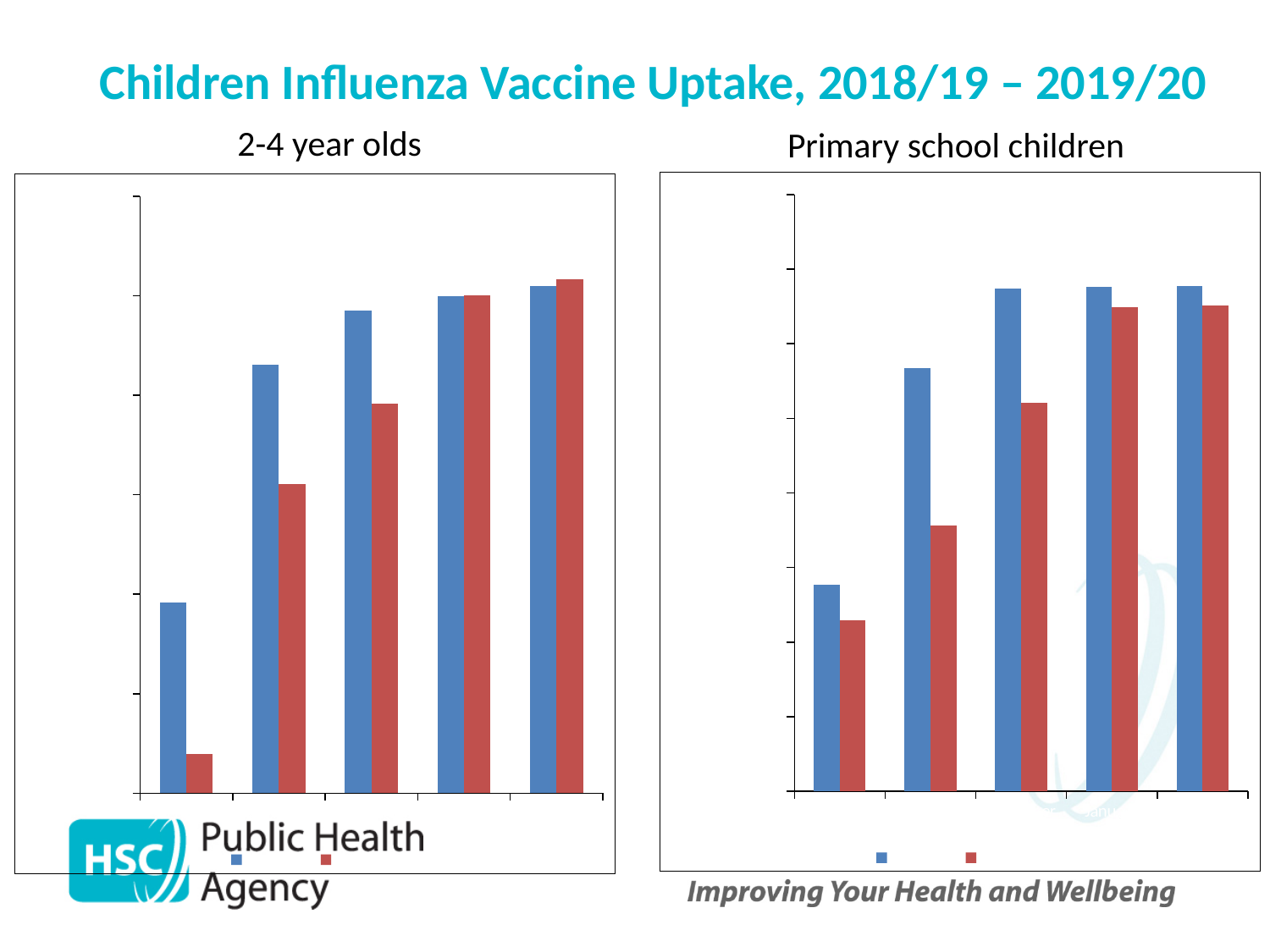
How many series does the legend of the 'Primary school children' chart show? 2 On the '2-4 year olds' chart, do the blue bars rise or fall from left to right? rise How many groups of bars are plotted on the '2-4 year olds' chart? 5 On the 'Primary school children' chart, do the red bars rise or fall from left to right? rise On the '2-4 year olds' chart, which group has the shortest red bar? the leftmost group How many groups of bars are plotted on the 'Primary school children' chart? 5 What kind of chart is the '2-4 year olds' chart? bar chart What two colours are used for the bars on the 'Primary school children' chart? blue and red On the 'Primary school children' chart, in the second group from the left, which bar is taller, the blue or the red? blue How many series does the legend of the '2-4 year olds' chart show? 2 What kind of chart is the 'Primary school children' chart? bar chart On the '2-4 year olds' chart, in the leftmost group, which bar is taller, the blue or the red? blue